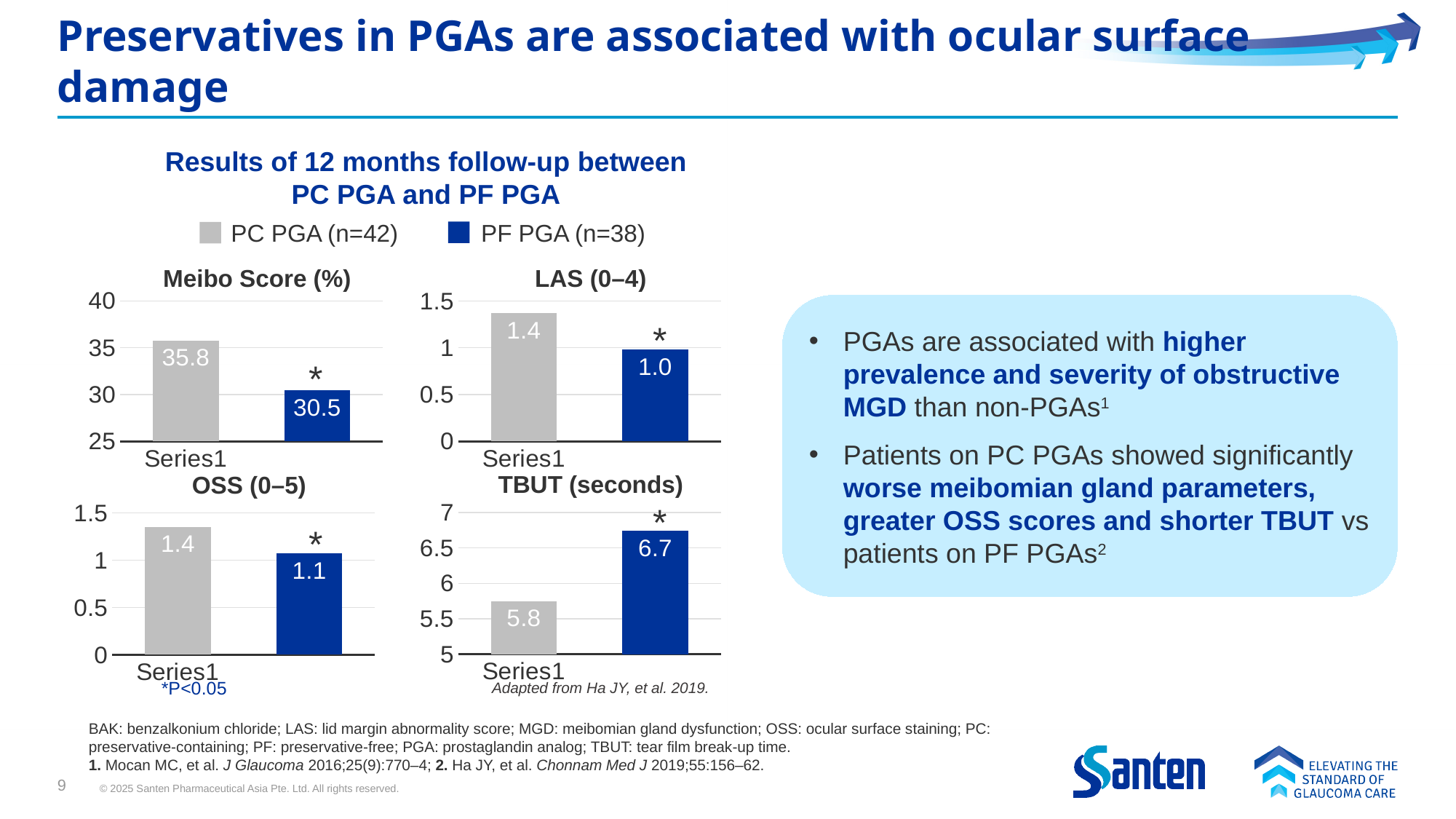
What kind of chart is the LAS (0–4) chart? Bar chart In the TBUT (seconds) chart, what is the value for PC PGA? 5.8 In the OSS (0–5) chart, what is the value for PC PGA? 1.4 How many series does the legend list? 2 In the Meibo Score (%) chart, what is the value for PC PGA? 35.8 In the TBUT (seconds) chart, which group has the higher value, PC PGA or PF PGA? PF PGA In the Meibo Score (%) chart, what is the value for PF PGA? 30.5 In the Meibo Score (%) chart, what is the difference between the PC PGA and PF PGA values? 5.3 In the OSS (0–5) chart, which group has the lower value? PF PGA In the LAS (0–4) chart, what is the value for PF PGA? 1.0 In the TBUT (seconds) chart, what is the difference between the PF PGA and PC PGA values? 0.9 According to the legend, how many patients were in the PF PGA group? 38